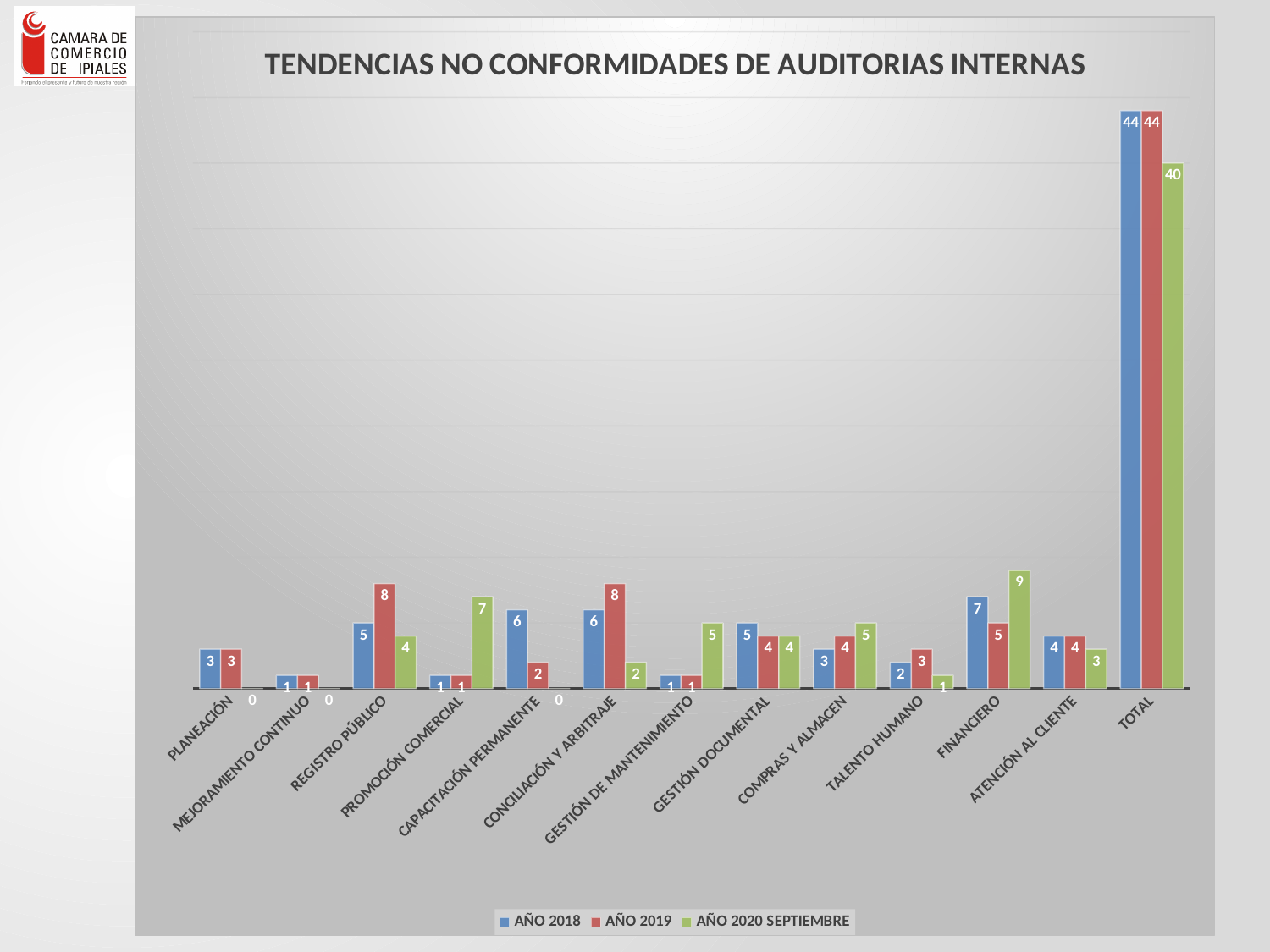
What is the value for CAPACITACIÓN PERMANENTE in the AÑO 2018 series? 6 Excluding TOTAL, which category has the highest value in the AÑO 2020 SEPTIEMBRE series? FINANCIERO What is the TOTAL value for the AÑO 2020 SEPTIEMBRE series? 40 Which is larger for PROMOCIÓN COMERCIAL: the AÑO 2018 value or the AÑO 2020 SEPTIEMBRE value? AÑO 2020 SEPTIEMBRE How many series does the legend list? 3 What is the difference between the AÑO 2019 and AÑO 2018 values for REGISTRO PÚBLICO? 3 What is the value for REGISTRO PÚBLICO in the AÑO 2019 series? 8 How many categories are shown on the x axis, including TOTAL? 13 What is the difference between the AÑO 2019 and AÑO 2020 SEPTIEMBRE TOTAL values? 4 Excluding TOTAL, which category has the highest value in the AÑO 2018 series? FINANCIERO What type of chart is shown on the slide? Bar chart What is the value for FINANCIERO in the AÑO 2020 SEPTIEMBRE series? 9